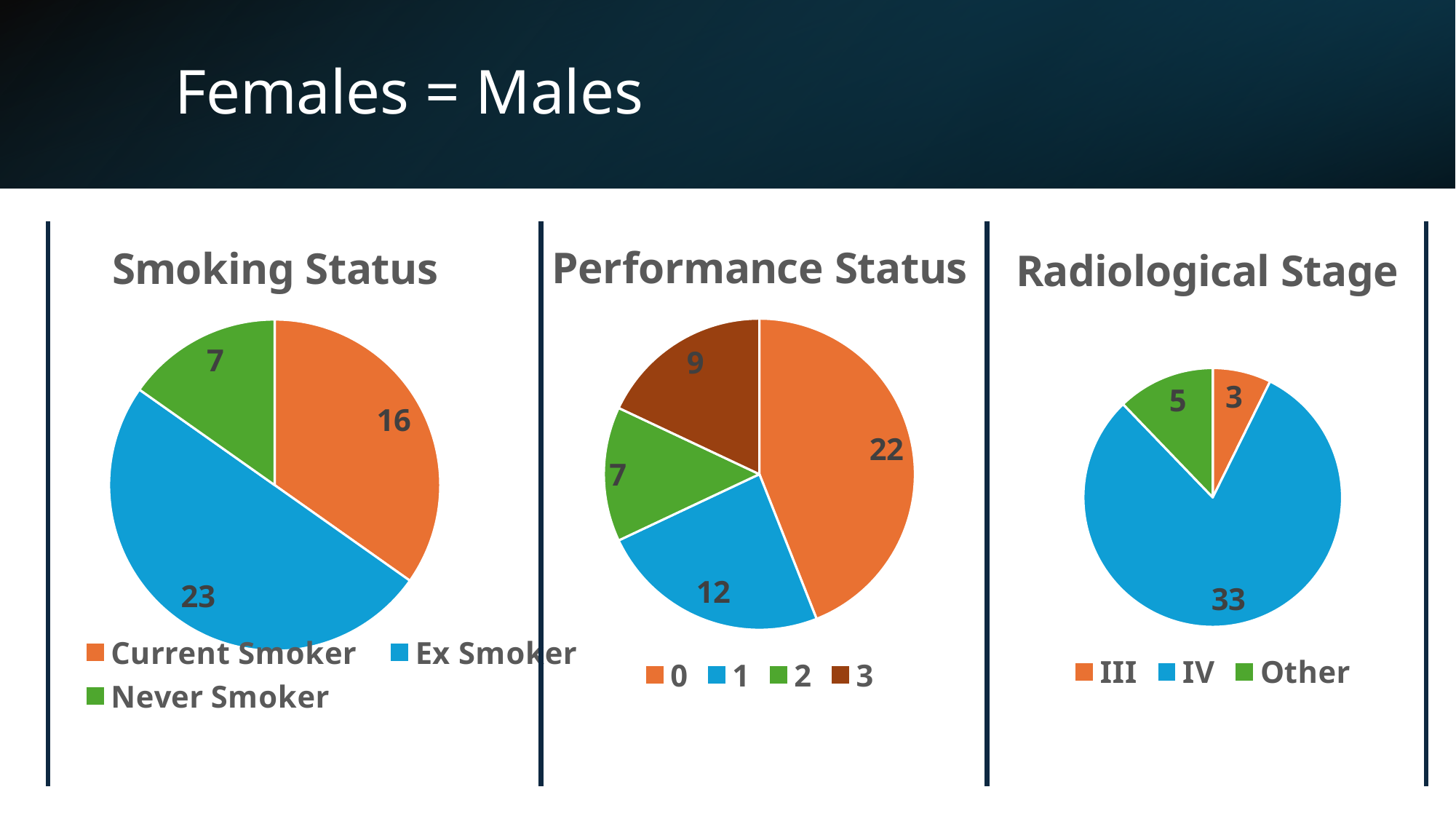
In the Performance Status chart, what is the value for category 3? 9 In the Smoking Status chart, what share of the pie does Ex Smoker represent? 50% In the Radiological Stage chart, what is the value for stage III? 3 In the Performance Status chart, how many categories are shown? 4 In the Performance Status chart, which category has the largest slice? 0 In the Smoking Status chart, which category has the smallest slice? Never Smoker In the Radiological Stage chart, what is the difference between IV and Other? 28 In the Smoking Status chart, what is the value for Ex Smoker? 23 In the Performance Status chart, what is the total of all slices? 50 What type of chart is the Smoking Status chart? Pie chart In the Smoking Status chart, what is the difference between Ex Smoker and Current Smoker? 7 In the Radiological Stage chart, which is larger, IV or Other? IV